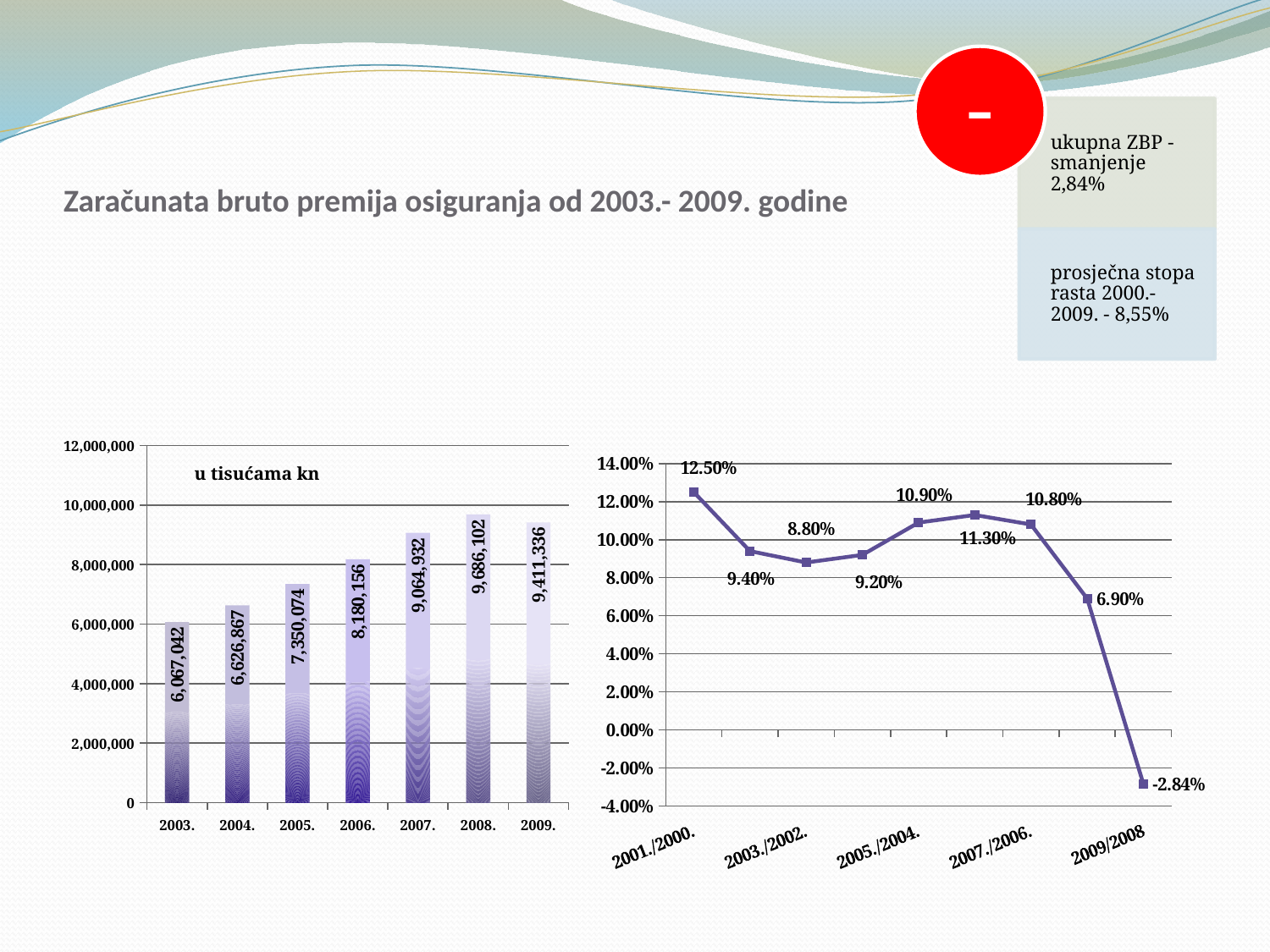
In the bar chart on the left, what is the difference between the values for 2008. and 2009.? 274,766 In the bar chart on the left, which year has the highest value? 2008. In the line chart on the right, what is the value for 2009/2008? -2.84% In the bar chart on the left, what is the value for 2006.? 8,180,156 In the bar chart on the left, how many years are shown? 7 What type of chart is the chart on the left? bar chart In the bar chart on the left, what is the value for 2009.? 9,411,336 In the bar chart on the left, which year has the lowest value? 2003. What unit label is shown inside the bar chart on the left? u tisućama kn In the line chart on the right, what is the value for 2001./2000.? 12.50% In the line chart on the right, how many data points are plotted? 9 In the line chart on the right, which is larger: the value for 2005./2004. or the value for 2003./2002.? 2005./2004.